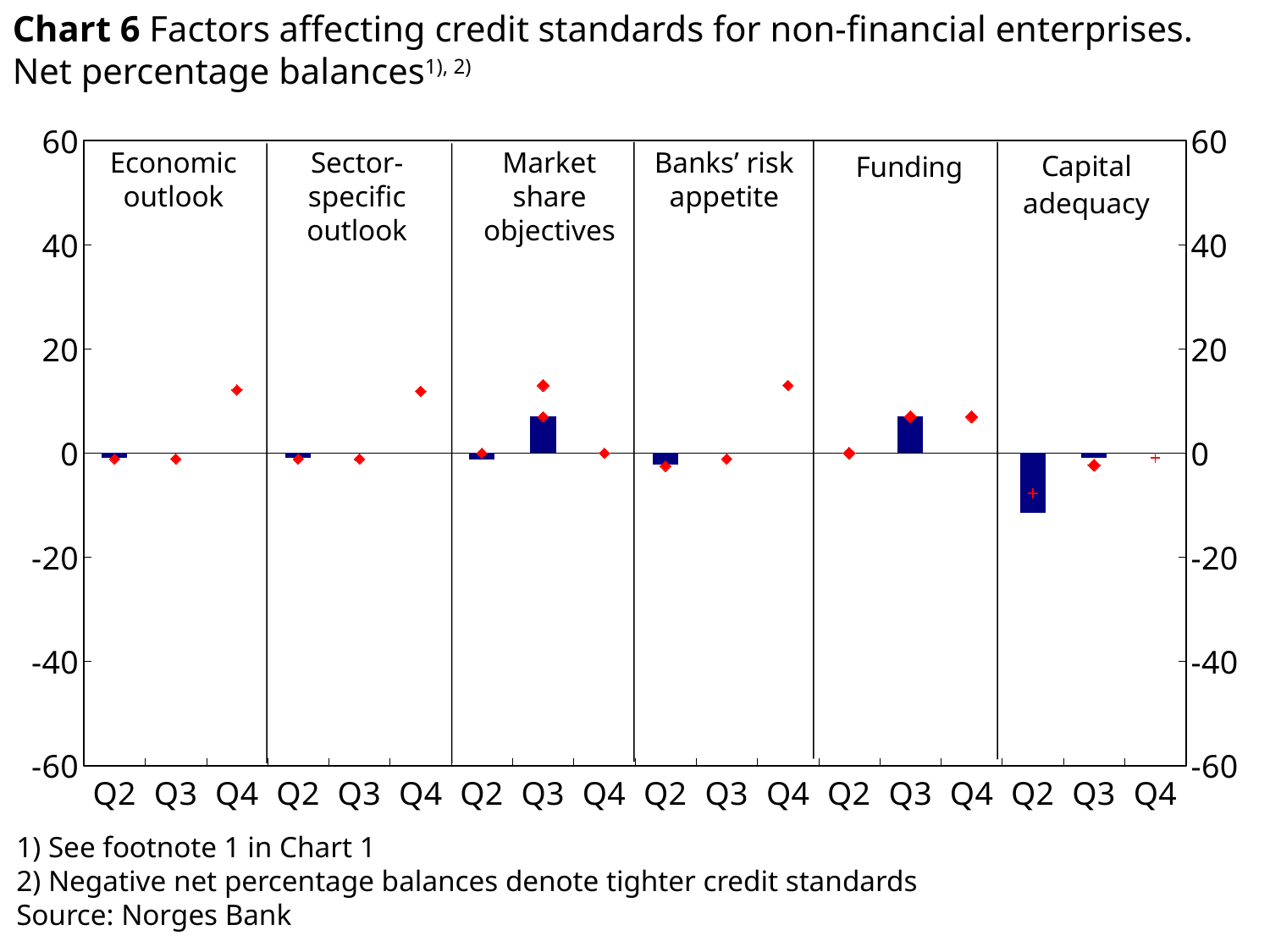
What is the chart number given in the title? Chart 6 How many quarters are shown within each factor panel? 3 Is the Q2 bar for Capital adequacy greater or less than -20? greater How many factors (panels) are shown along the x axis of the chart? 6 Which factor has the lowest (most negative) Q2 bar? Capital adequacy Is the Q3 bar for Market share objectives greater or less than 20? less Is the Q3 bar for Funding greater or less than 0? greater What kind of chart is shown on the slide? combination bar and line chart (bars with point markers) What is the source cited for the chart? Norges Bank Which is larger: the Q2 bar for Capital adequacy or the Q3 bar for Funding? Q3 bar for Funding